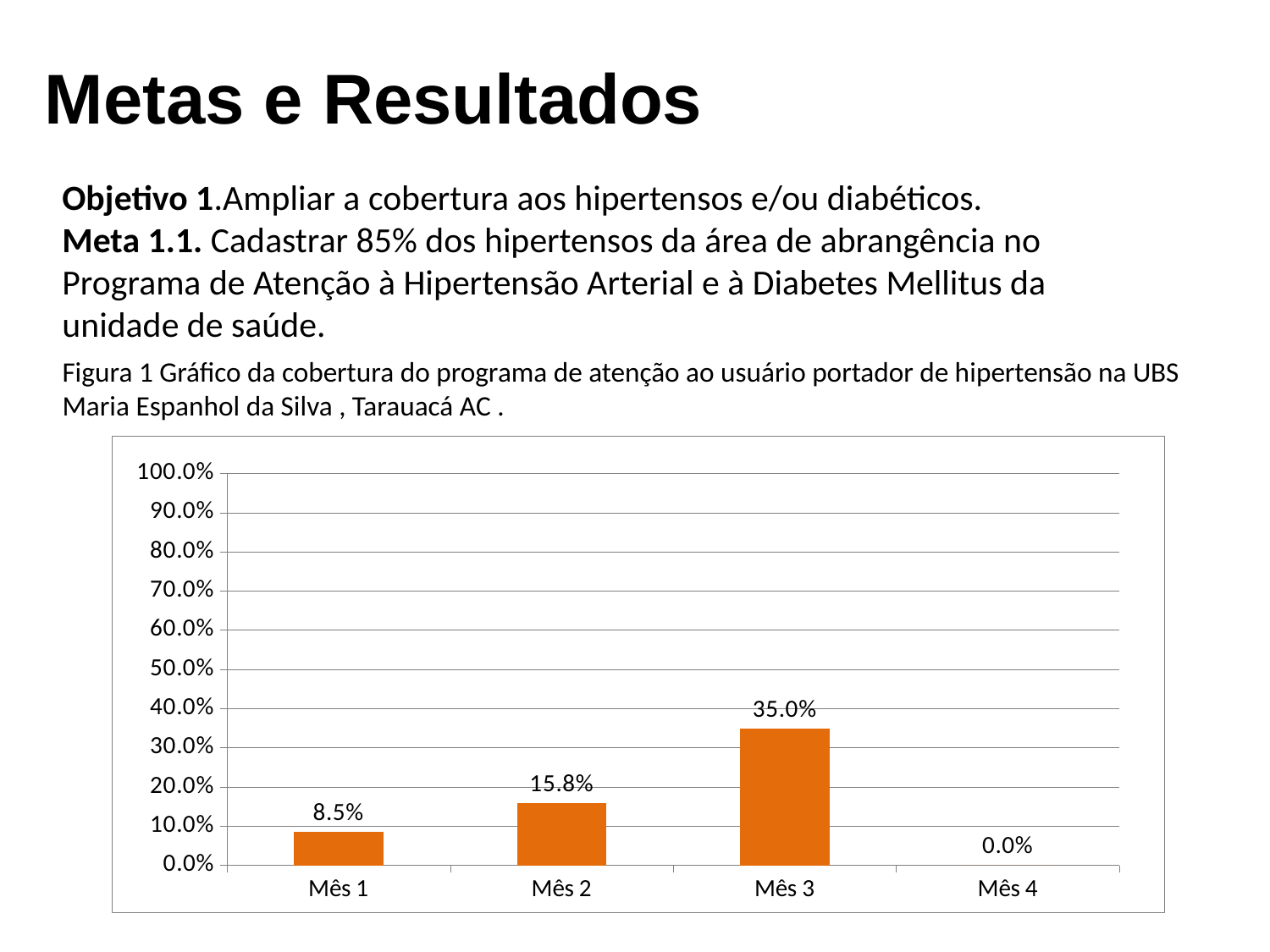
What is the value for Mês 4? 0.0% What is the value for Mês 3? 35.0% How many categories are shown on the x axis? 4 What is the value for Mês 1? 8.5% What kind of chart is shown on the slide? bar chart Do the values rise or fall from Mês 1 to Mês 3? rise What is the value for Mês 2? 15.8% Which is larger, the value for Mês 1 or the value for Mês 2? Mês 2 Is the value for Mês 3 greater or less than 30.0%? greater Which category has the highest value? Mês 3 Which category has the lowest value? Mês 4 What is the difference between the values for Mês 3 and Mês 2? 19.2%